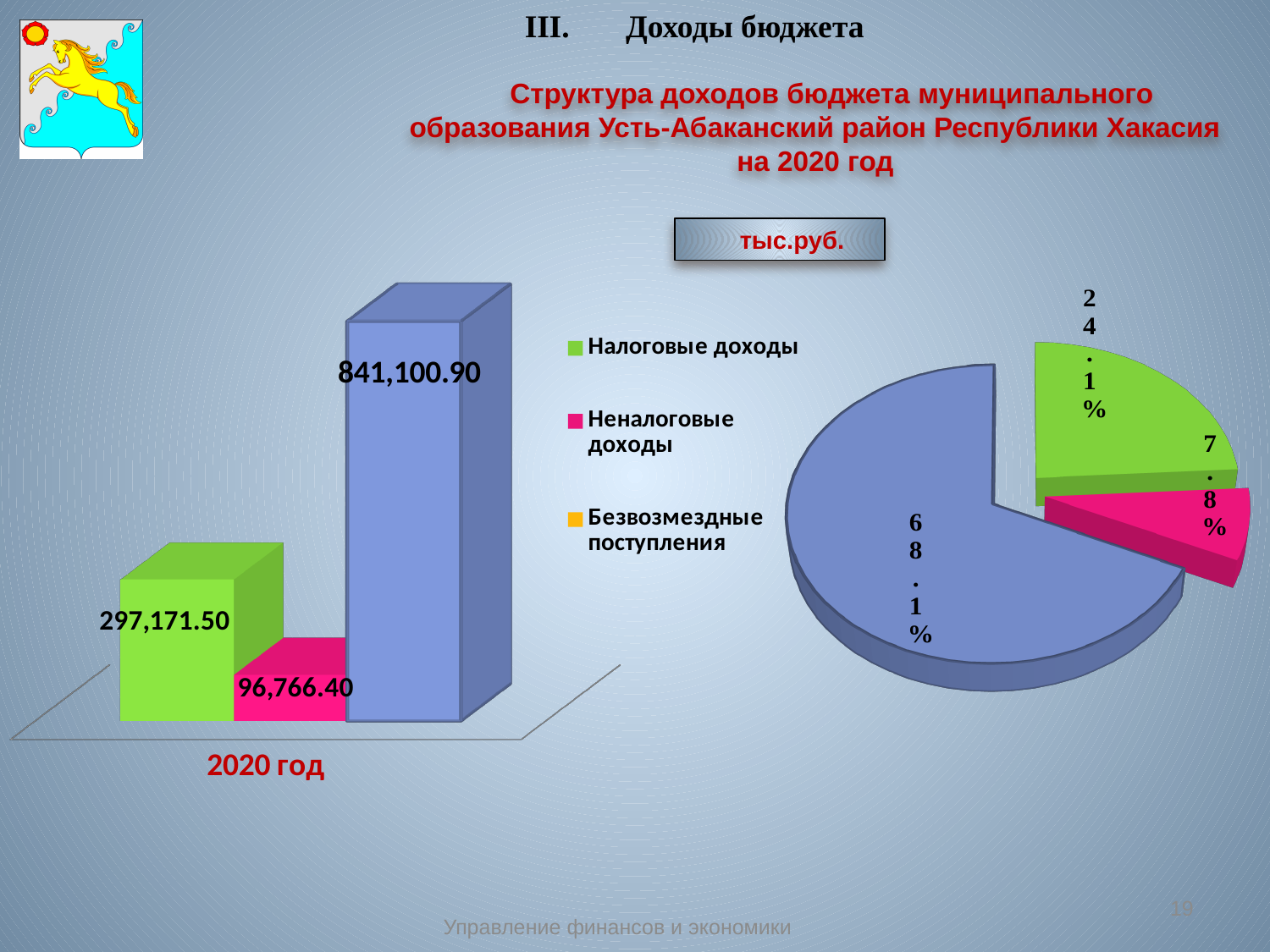
On the bar chart on the left, what is the value for Неналоговые доходы? 96,766.40 What type of chart is shown on the right side of the slide? Pie chart How many entries does the legend between the two charts list? 3 On the pie chart on the right, what share does the green slice (Налоговые доходы) have? 24.1% On the bar chart on the left, which category has the lowest value? Неналоговые доходы How many bars are shown on the bar chart on the left? 3 On the pie chart on the right, what share does the largest (blue) slice have? 68.1% On the bar chart on the left, which category has the highest value? Безвозмездные поступления On the bar chart on the left, what is the value of the tallest (blue) bar? 841,100.90 On the bar chart on the left, what is the value for Налоговые доходы? 297,171.50 On the bar chart on the left, what is the difference between the values for Налоговые доходы and Неналоговые доходы? 200,405.10 On the bar chart on the left, which is larger: Налоговые доходы or Неналоговые доходы? Налоговые доходы